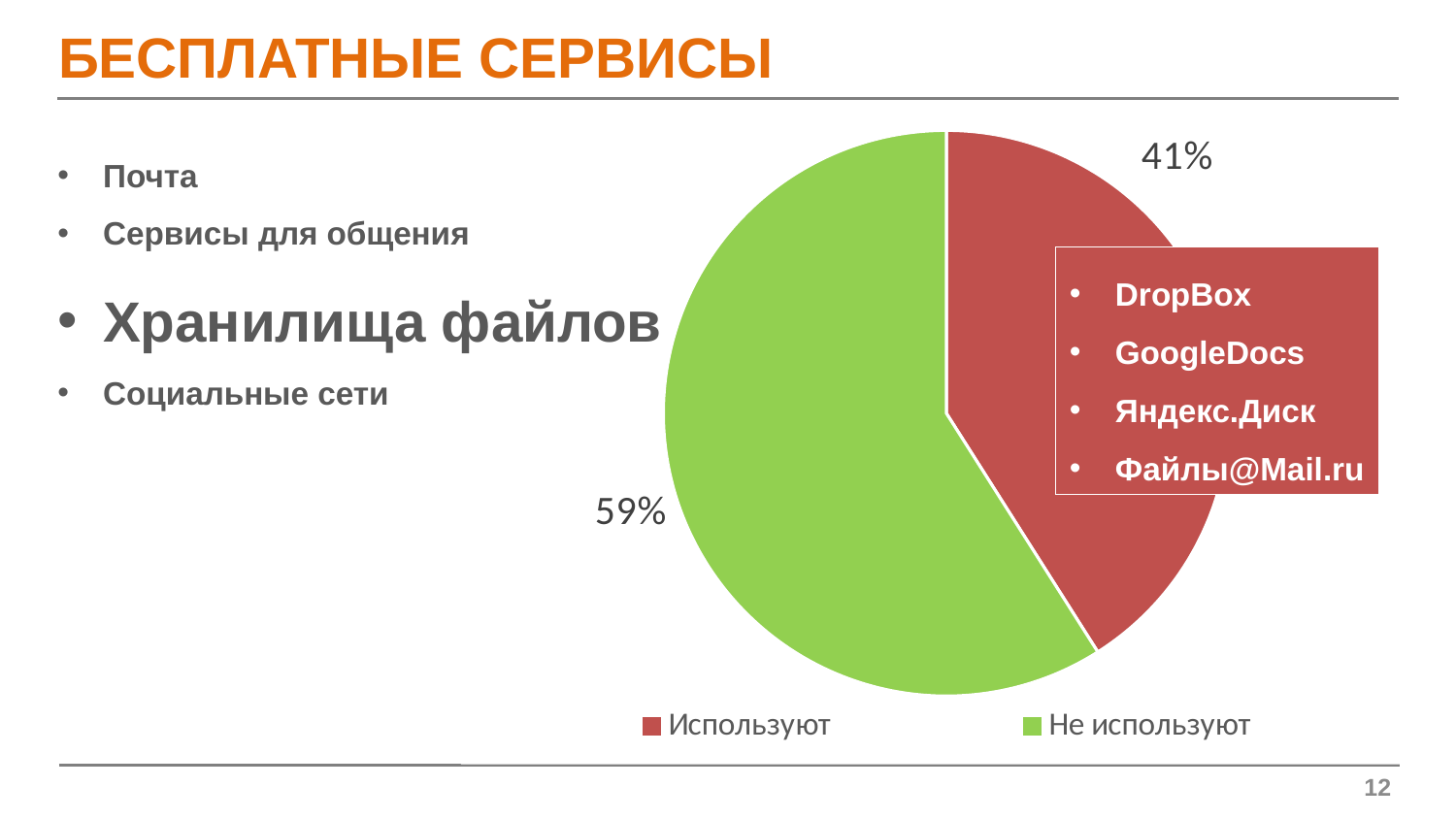
How many slices does the pie chart have? 2 What share of the pie is labelled "Используют"? 41% Is the share for "Используют" greater or less than 50%? less Which is larger: the "Используют" slice or the "Не используют" slice? Не используют What kind of chart is shown on the slide? pie chart Which slice of the pie is the largest? Не используют What colour is the "Используют" slice? red What is the difference in percentage points between the "Не используют" and "Используют" slices? 18 Which slice of the pie is the smallest? Используют What share of the pie is labelled "Не используют"? 59% How many entries does the legend list? 2 What colour is the "Не используют" slice? green